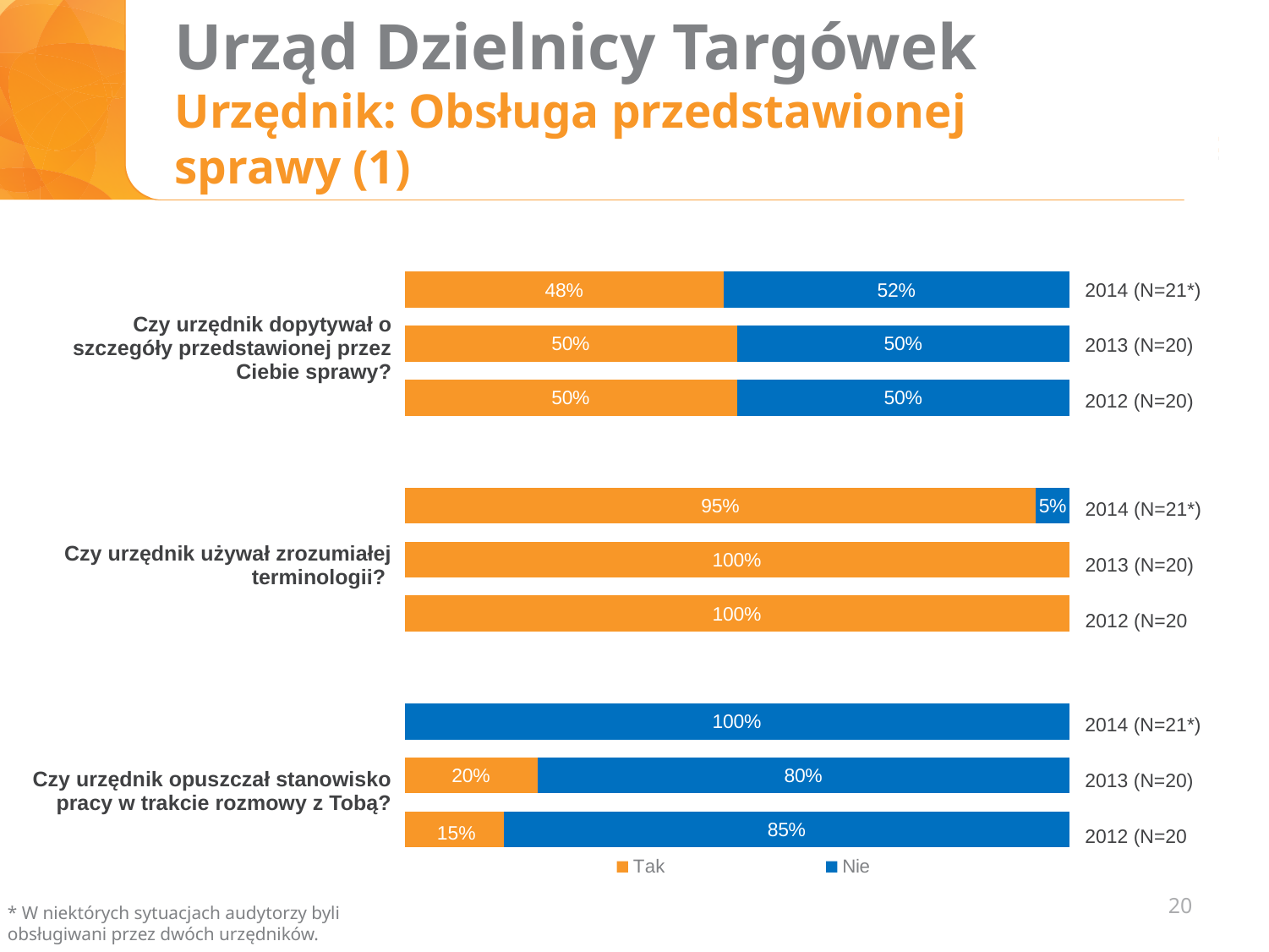
What kind of chart is shown on the slide? Stacked bar chart In the chart for 'Czy urzędnik opuszczał stanowisko pracy w trakcie rozmowy z Tobą?', what is the 'Tak' value for 2012 (N=20)? 15% In the chart for 'Czy urzędnik używał zrozumiałej terminologii?', what is the 'Tak' value for 2013 (N=20)? 100% How many series does the legend list? 2 In the chart for 'Czy urzędnik dopytywał o szczegóły przedstawionej przez Ciebie sprawy?', what is the 'Nie' value for 2014 (N=21*)? 52% In the chart for 'Czy urzędnik używał zrozumiałej terminologii?', what is the 'Nie' value for 2014 (N=21*)? 5% In the chart for 'Czy urzędnik opuszczał stanowisko pracy w trakcie rozmowy z Tobą?', which year has the highest 'Nie' value? 2014 (N=21*) In the chart for 'Czy urzędnik opuszczał stanowisko pracy w trakcie rozmowy z Tobą?', what is the difference between the 'Nie' values for 2012 (N=20) and 2013 (N=20)? 5% In the chart for 'Czy urzędnik używał zrozumiałej terminologii?', which year has the lowest 'Tak' value? 2014 (N=21*) In the chart for 'Czy urzędnik dopytywał o szczegóły przedstawionej przez Ciebie sprawy?', what is the 'Tak' value for 2014 (N=21*)? 48% In the chart for 'Czy urzędnik opuszczał stanowisko pracy w trakcie rozmowy z Tobą?', what is the 'Nie' value for 2013 (N=20)? 80% In the chart for 'Czy urzędnik dopytywał o szczegóły przedstawionej przez Ciebie sprawy?', which is larger for 2014 (N=21*): 'Tak' or 'Nie'? Nie